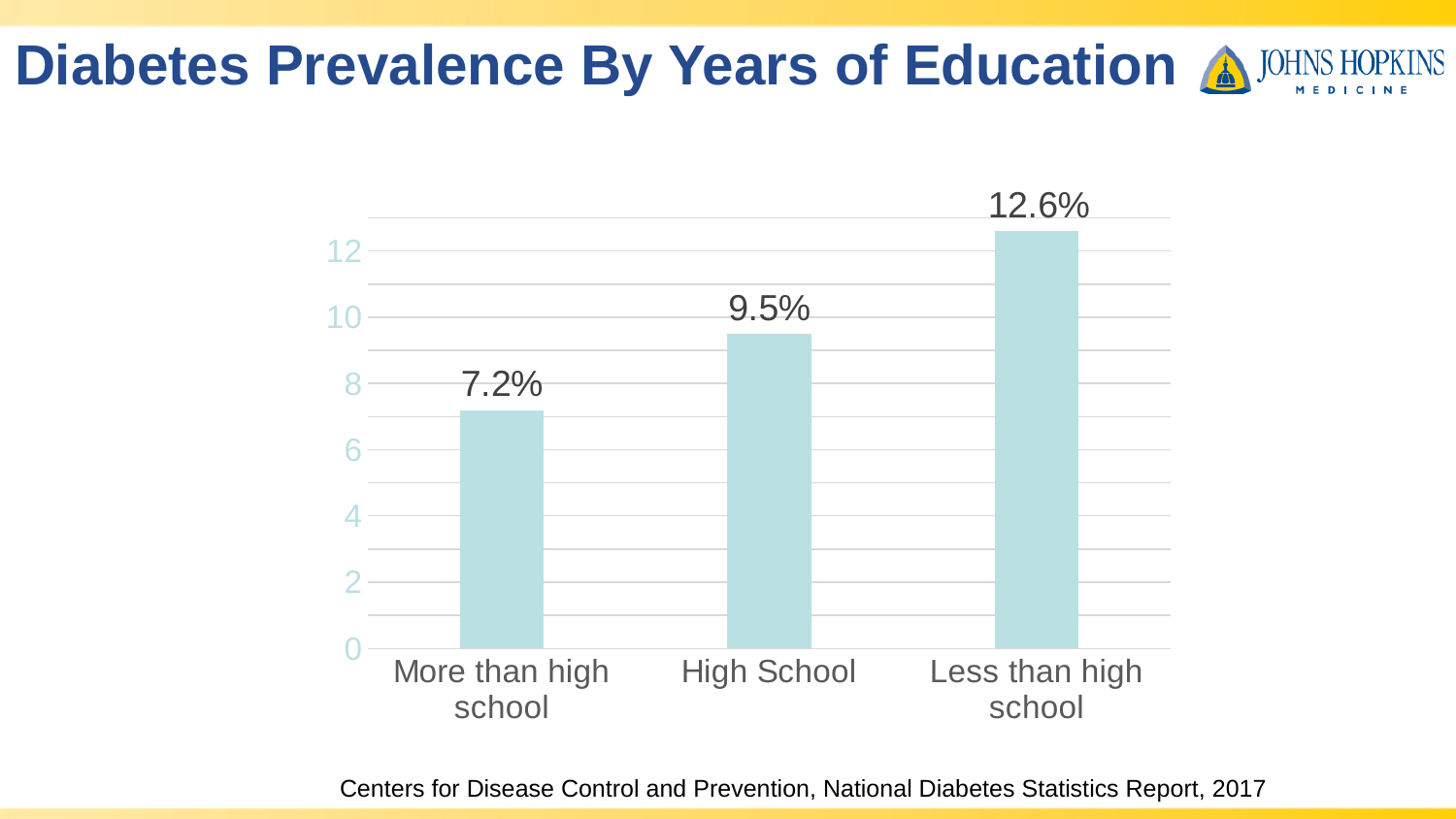
What is the diabetes prevalence for the 'High School' category? 9.5% What is the diabetes prevalence for the 'Less than high school' category? 12.6% Which has a higher diabetes prevalence, 'High School' or 'More than high school'? High School What is the difference in diabetes prevalence between 'High School' and 'More than high school'? 2.3% What is the difference in diabetes prevalence between 'Less than high school' and 'More than high school'? 5.4% Which education category has the highest diabetes prevalence? Less than high school How many education categories are shown in the chart? 3 What kind of chart is shown on the slide? Bar chart What is the diabetes prevalence for the 'More than high school' category? 7.2% Which education category has the lowest diabetes prevalence? More than high school Is the value for 'Less than high school' greater or less than 12? greater What is the title of the slide? Diabetes Prevalence By Years of Education